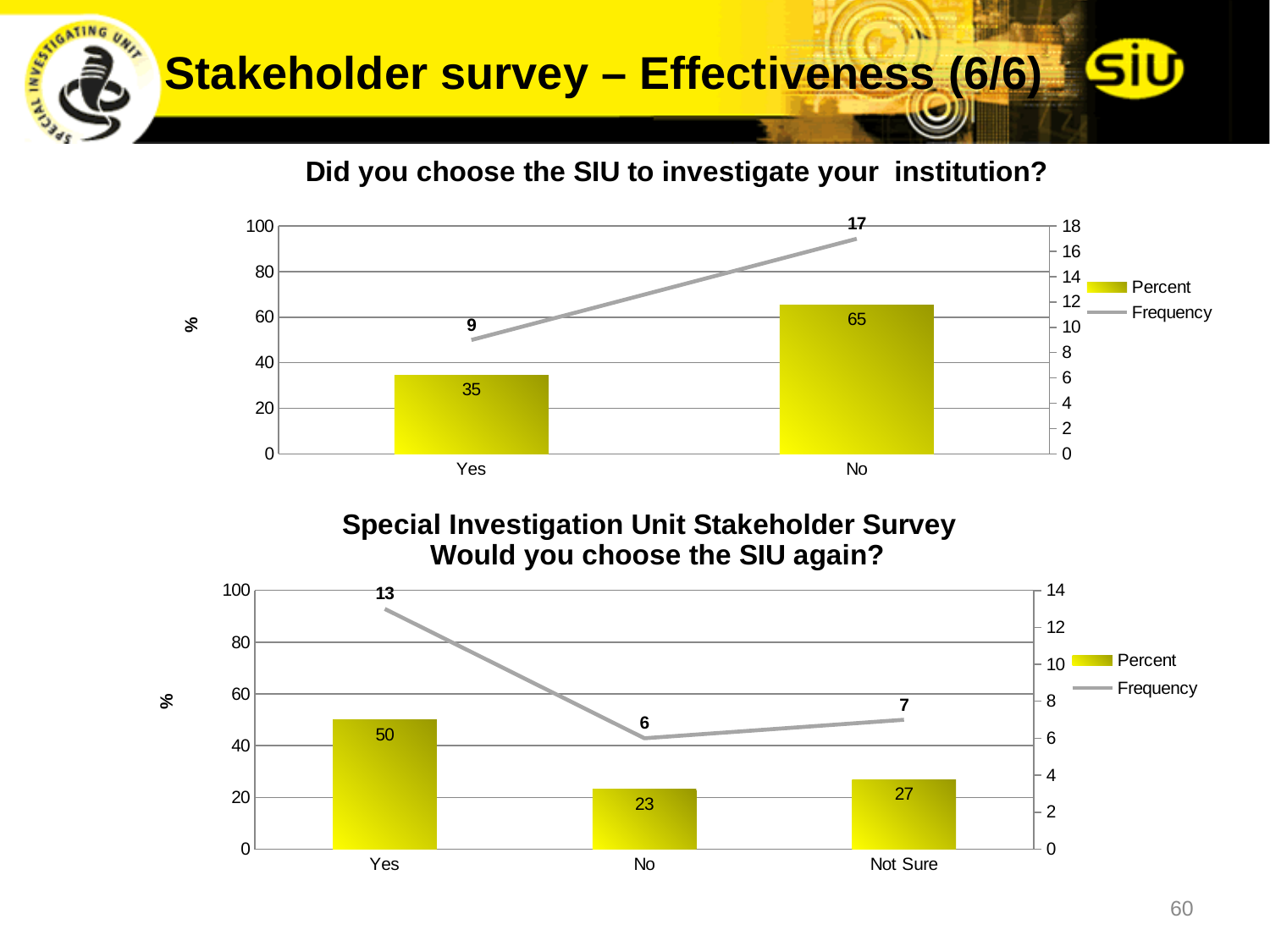
In the top chart 'Did you choose the SIU to investigate your institution?', how many series does the legend list? 2 In the top chart 'Did you choose the SIU to investigate your institution?', what is the Percent value for No? 65 In the top chart 'Did you choose the SIU to investigate your institution?', what is the Frequency value for Yes? 9 In the top chart 'Did you choose the SIU to investigate your institution?', does the Frequency line rise or fall from Yes to No? rise In the top chart 'Did you choose the SIU to investigate your institution?', what is the difference between the Percent values for No and Yes? 30 In the bottom chart 'Would you choose the SIU again?', what is the difference between the Frequency values for Yes and No? 7 In the bottom chart 'Would you choose the SIU again?', what is the Percent value for Not Sure? 27 In the bottom chart 'Would you choose the SIU again?', how many categories are shown on the x axis? 3 In the bottom chart 'Would you choose the SIU again?', what is the Frequency value for Yes? 13 In the bottom chart 'Would you choose the SIU again?', which series is drawn as a line? Frequency In the bottom chart 'Would you choose the SIU again?', which category has the lowest Percent value? No In the bottom chart 'Would you choose the SIU again?', which category has the highest Frequency value? Yes